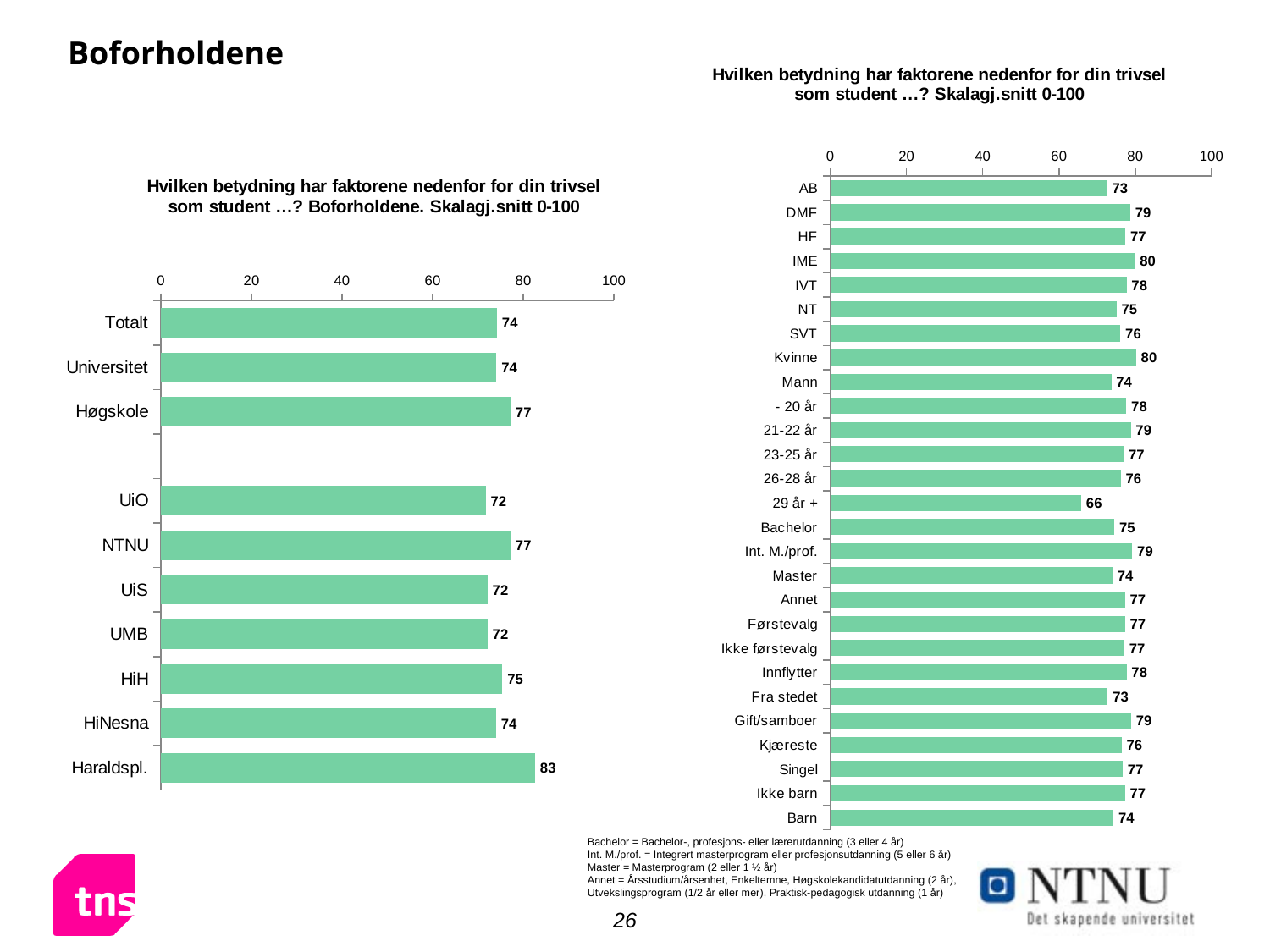
In the left chart, which category has the highest value? Haraldspl. In the left chart, what is the difference between the values for Haraldspl. and UiO? 11 In the right chart, is the value for 29 år + greater or less than 80? less In the right chart, what is the value for Kvinne? 80 In the right chart, which category has the lowest value? 29 år + In the left chart, which is larger, the value for NTNU or the value for UiS? NTNU In the right chart, how many categories are plotted? 27 In the right chart, what is the value for 29 år +? 66 What kind of chart is the left chart? Bar chart In the left chart, what is the value for Haraldspl.? 83 In the left chart, how many categories are plotted? 10 In the right chart, what is the difference between the values for Kvinne and Mann? 6